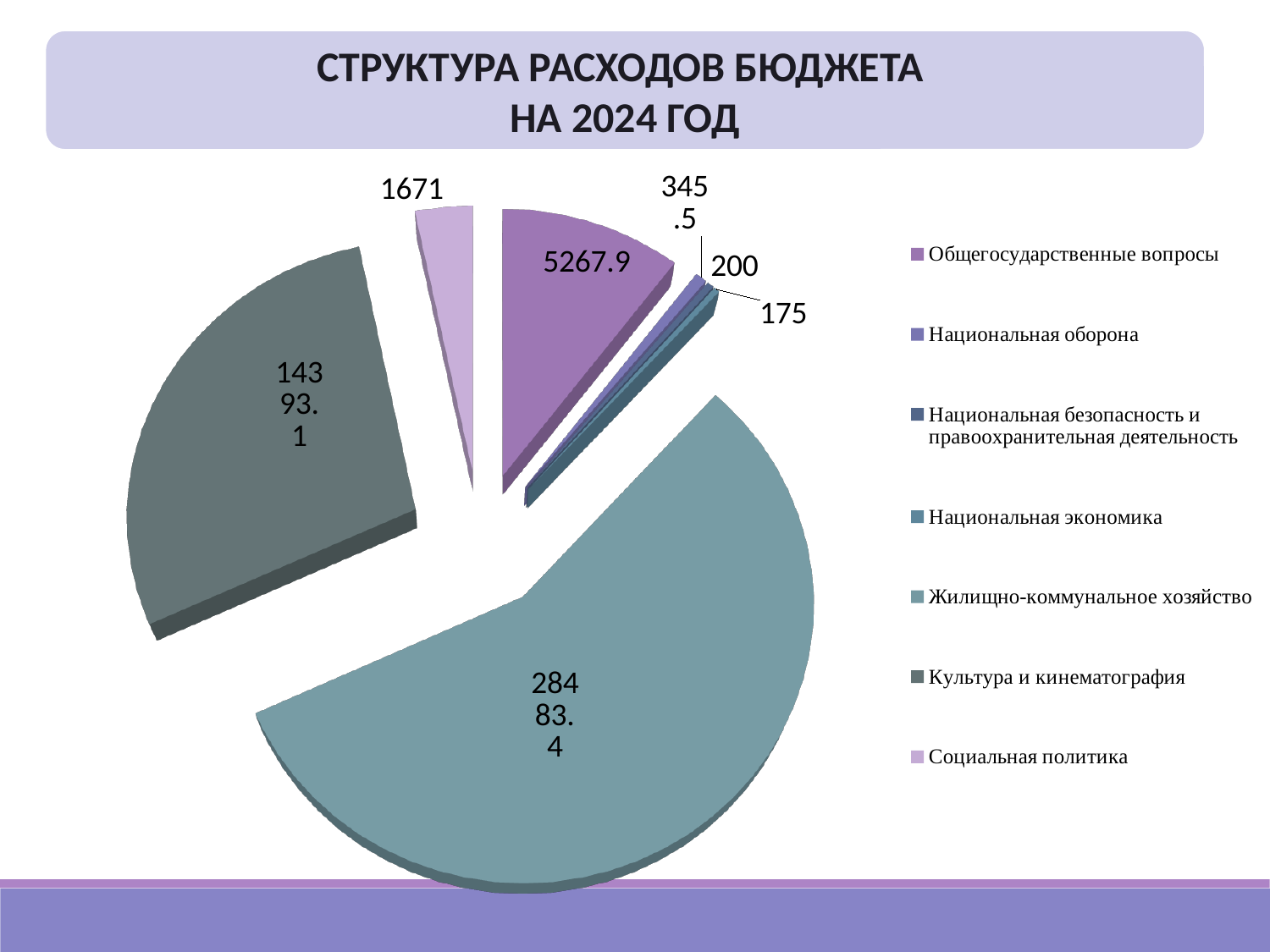
How many categories does the legend list? 7 What type of chart is shown on the slide? pie chart What is the value for Национальная оборона? 345.5 What is the value for Общегосударственные вопросы? 5267.9 What is the value for Социальная политика? 1671 What is the value for Культура и кинематография? 14393.1 Which category has the largest slice of the pie? Жилищно-коммунальное хозяйство What is the value for Жилищно-коммунальное хозяйство? 28483.4 Which category has the smallest slice of the pie? Национальная экономика What is the difference between the values for Жилищно-коммунальное хозяйство and Культура и кинематография? 14090.3 What is the title of the chart on the slide? СТРУКТУРА РАСХОДОВ БЮДЖЕТА НА 2024 ГОД Which is larger: the value for Национальная оборона or the value for Национальная безопасность и правоохранительная деятельность? Национальная оборона